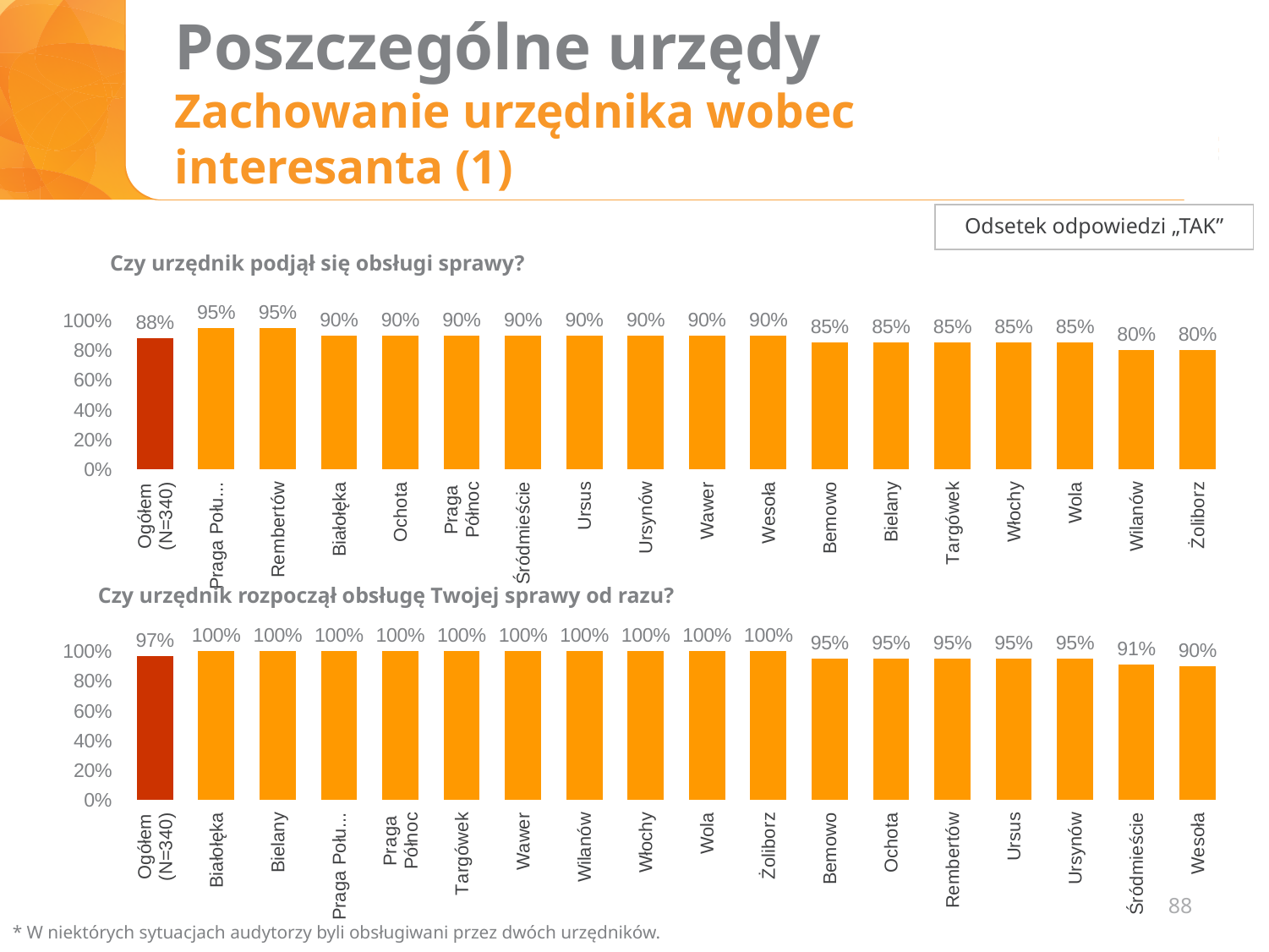
In the top chart 'Czy urzędnik podjął się obsługi sprawy?', which is larger, Ochota or Bemowo? Ochota In the top chart 'Czy urzędnik podjął się obsługi sprawy?', what is the difference between Rembertów and Wilanów? 15% In the bottom chart 'Czy urzędnik rozpoczął obsługę Twojej sprawy od razu?', what is the difference between Białołęka and Wesoła? 10% In the bottom chart 'Czy urzędnik rozpoczął obsługę Twojej sprawy od razu?', which is larger, Wola or Ursus? Wola In the bottom chart 'Czy urzędnik rozpoczął obsługę Twojej sprawy od razu?', which category has the lowest value? Wesoła What type of chart is the top chart 'Czy urzędnik podjął się obsługi sprawy?'? Bar chart In the top chart 'Czy urzędnik podjął się obsługi sprawy?', what is the value for Ogółem (N=340)? 88% In the top chart 'Czy urzędnik podjął się obsługi sprawy?', what is the value for Rembertów? 95% In the bottom chart 'Czy urzędnik rozpoczął obsługę Twojej sprawy od razu?', what is the value for Śródmieście? 91% In the top chart 'Czy urzędnik podjął się obsługi sprawy?', how many categories are shown on the x axis? 18 In the bottom chart 'Czy urzędnik rozpoczął obsługę Twojej sprawy od razu?', what is the value for Ogółem (N=340)? 97% In the top chart 'Czy urzędnik podjął się obsługi sprawy?', what is the value for Żoliborz? 80%